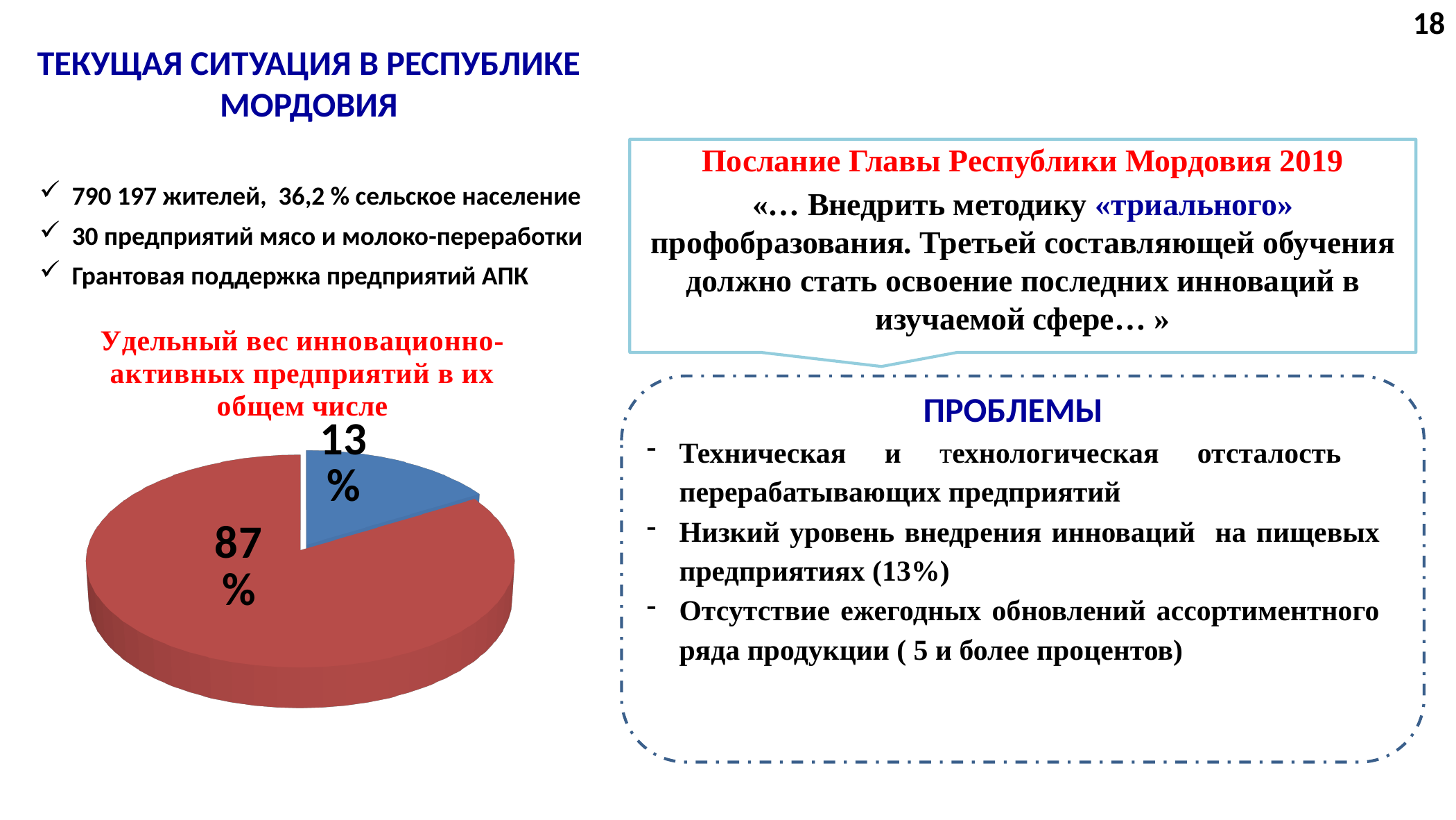
Which is larger in the pie chart, the blue slice or the red slice? the red slice How many slices does the pie chart have? 2 What kind of chart is shown on the slide? pie chart Which slice of the pie chart is the smallest? the blue slice (13%) What value is shown on the red slice of the pie chart? 87% What is the title of the pie chart? Удельный вес инновационно-активных предприятий в их общем числе What colour is the slice labelled 87% in the pie chart? red What is the total of the two slices shown in the pie chart? 100% Which slice of the pie chart is the largest? the red slice (87%) What value is shown on the blue slice of the pie chart? 13% What share of the pie does the blue slice represent? 13% What is the difference between the red slice and the blue slice of the pie chart? 74%